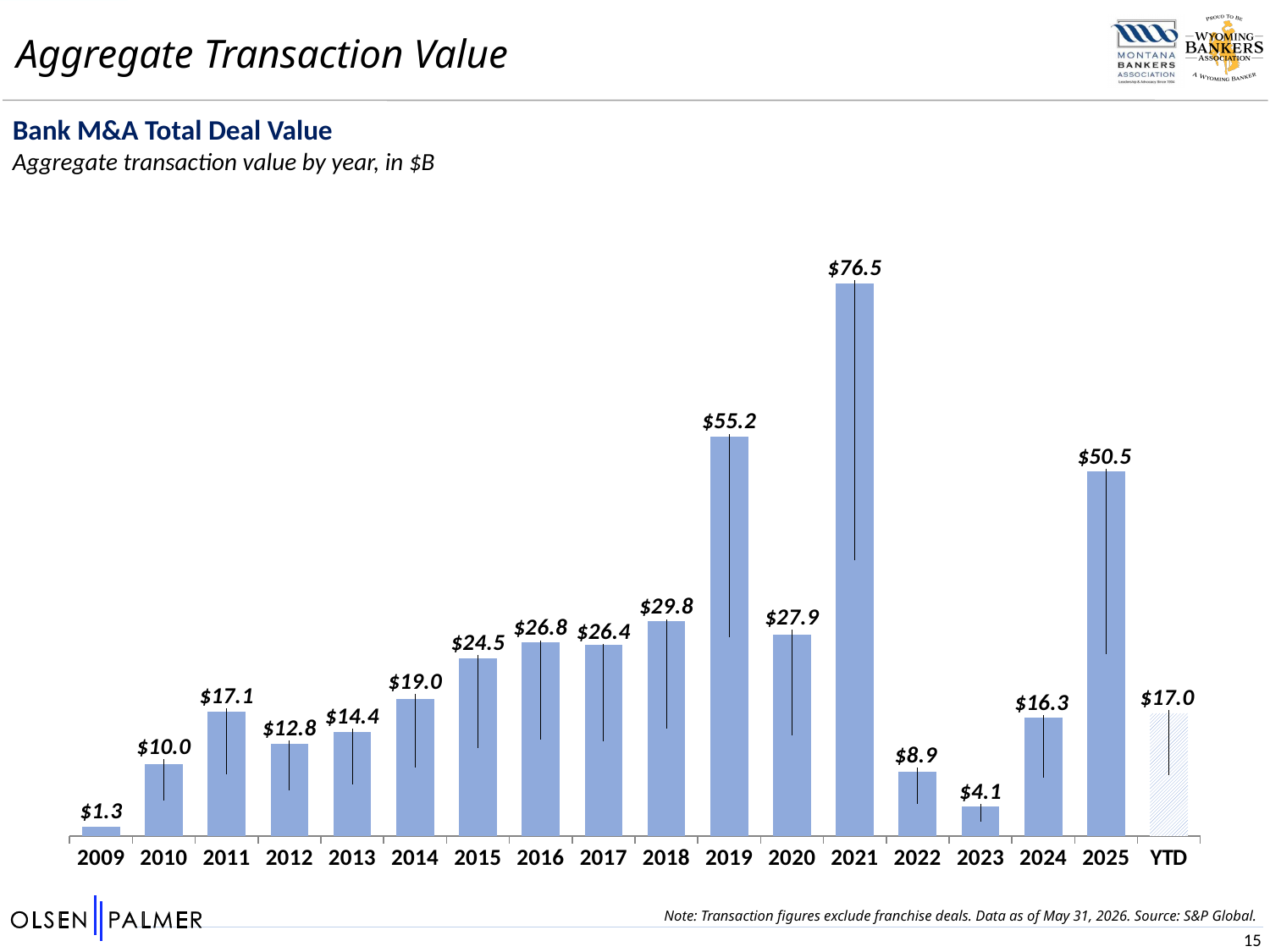
What is the title of the chart? Bank M&A Total Deal Value What is the difference between the 2021 and 2025 aggregate transaction values? $26.0 Which year has a larger aggregate transaction value, 2016 or 2017? 2016 What is the aggregate transaction value for YTD? $17.0 Which year has the highest aggregate transaction value? 2021 Which year has the lowest aggregate transaction value? 2009 What type of chart is shown on the slide? Bar chart What is the aggregate transaction value for 2021? $76.5 Which year has a larger aggregate transaction value, 2018 or 2020? 2018 How many bars are shown in the chart? 18 What is the aggregate transaction value for 2019? $55.2 What is the difference between the 2023 and 2024 aggregate transaction values? $12.2